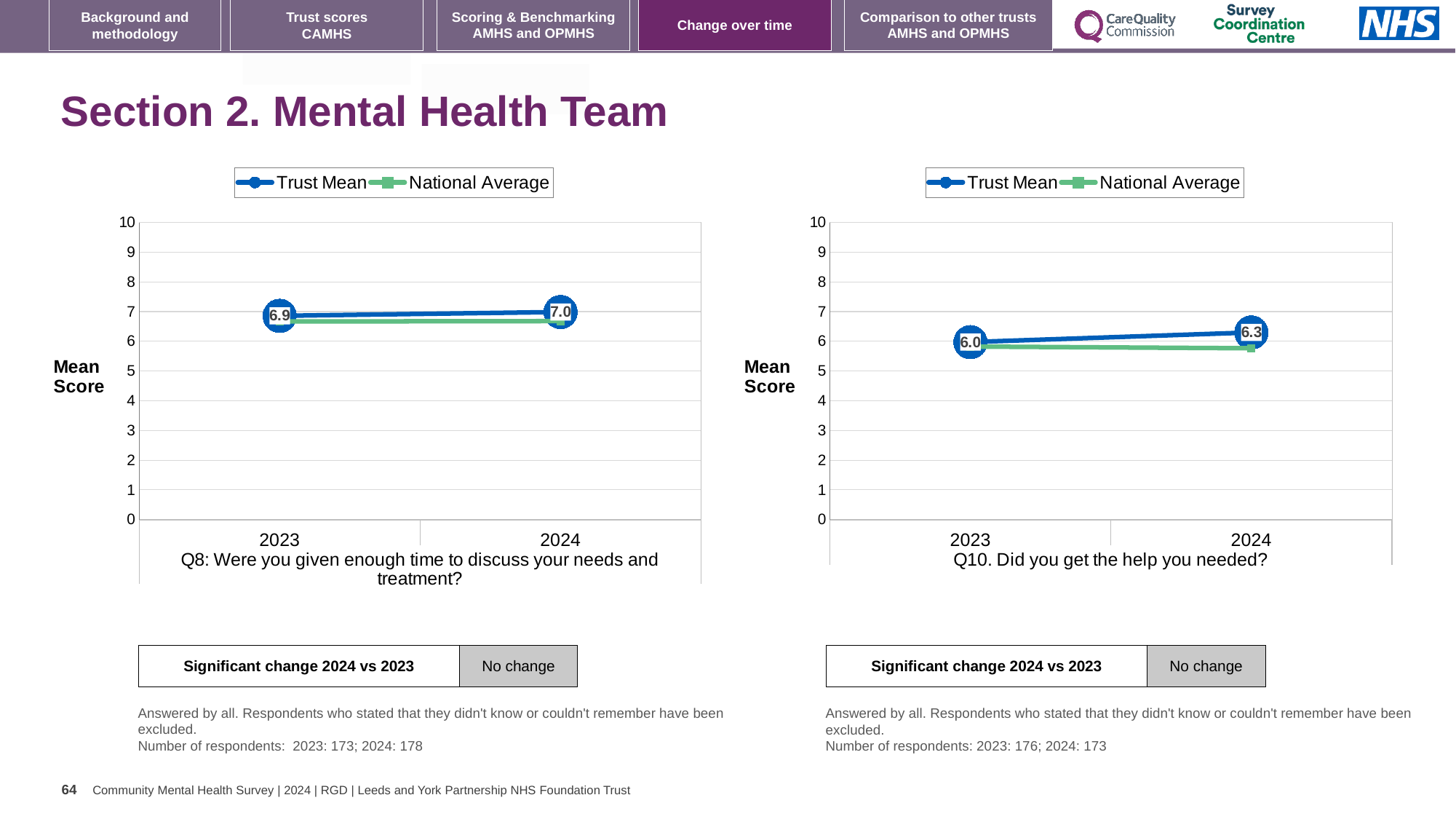
In the Q10 chart (right), which is higher in 2024, the Trust Mean or the National Average? Trust Mean In the Q10 chart (right), by how much did the Trust Mean change from 2023 to 2024? 0.3 In the Q10 chart (right), what is the Trust Mean for 2024? 6.3 In the Q8 chart (left), what is the Trust Mean for 2024? 7.0 What type of chart is the Q10 chart (right)? line chart In the Q10 chart (right), is the National Average for 2023 greater or less than 7? less In the Q8 chart (left), what is the Trust Mean for 2023? 6.9 In the Q8 chart (left), what is the difference between the Trust Mean in 2024 and 2023? 0.1 How many series does the legend of the Q8 chart (left) list? 2 In the Q8 chart (left), is the National Average for 2024 greater or less than 7? less In the Q10 chart (right), what is the Trust Mean for 2023? 6.0 In the Q10 chart (right), does the Trust Mean rise or fall from 2023 to 2024? rise